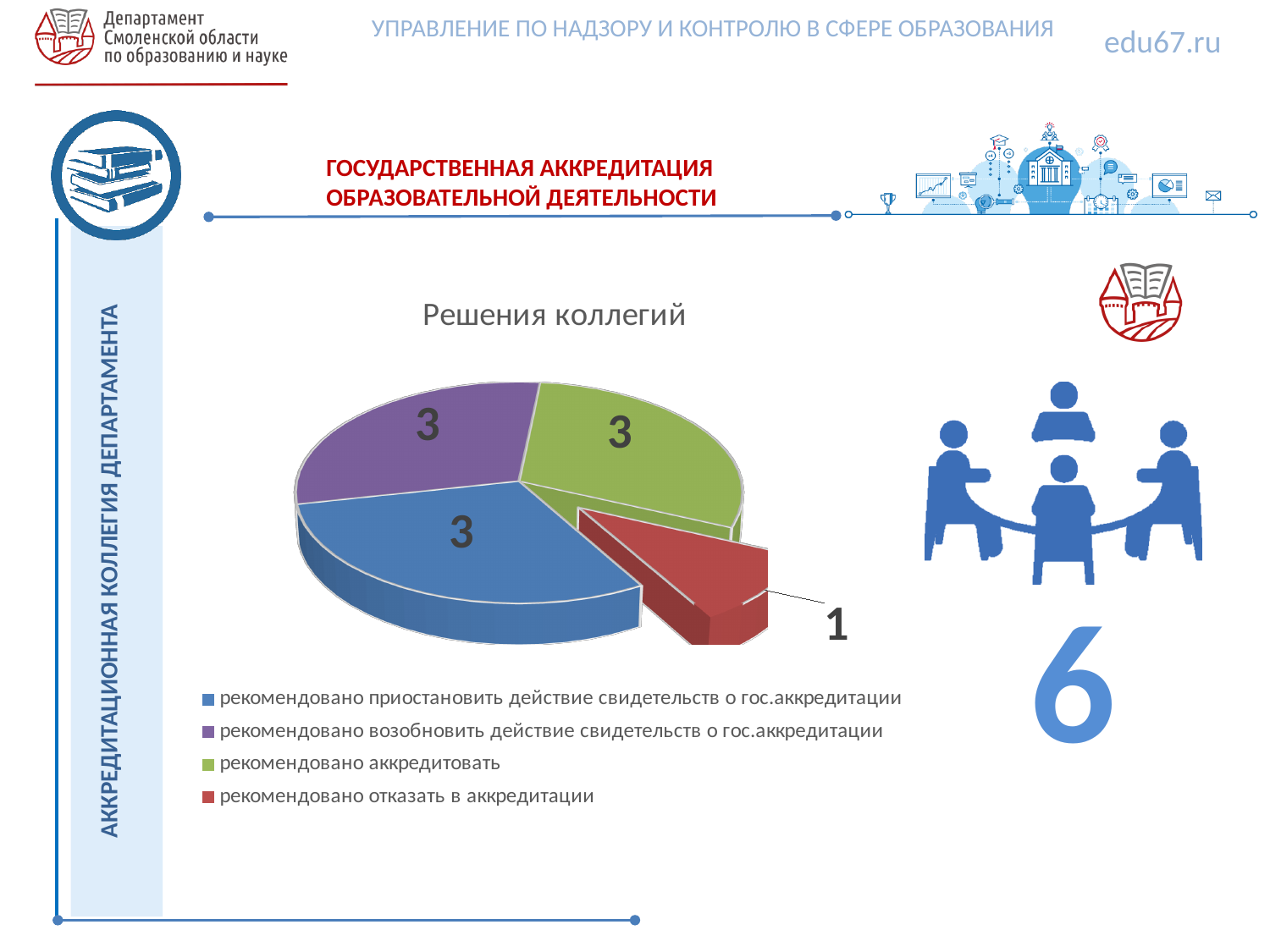
What is the value for "рекомендовано отказать в аккредитации"? 1 How many entries does the legend list? 4 What share of the pie does "рекомендовано отказать в аккредитации" represent? 10% Which is larger: the value for "рекомендовано аккредитовать" or the value for "рекомендовано отказать в аккредитации"? рекомендовано аккредитовать Which category has the smallest slice? рекомендовано отказать в аккредитации What type of chart is shown on the slide? pie chart How many slices does the pie chart have? 4 What is the difference between the value for "рекомендовано возобновить действие свидетельств о гос.аккредитации" and the value for "рекомендовано отказать в аккредитации"? 2 What is the title of the chart? Решения коллегий What is the total of all slices in the pie chart? 10 What is the value for "рекомендовано приостановить действие свидетельств о гос.аккредитации"? 3 What is the value for "рекомендовано аккредитовать"? 3